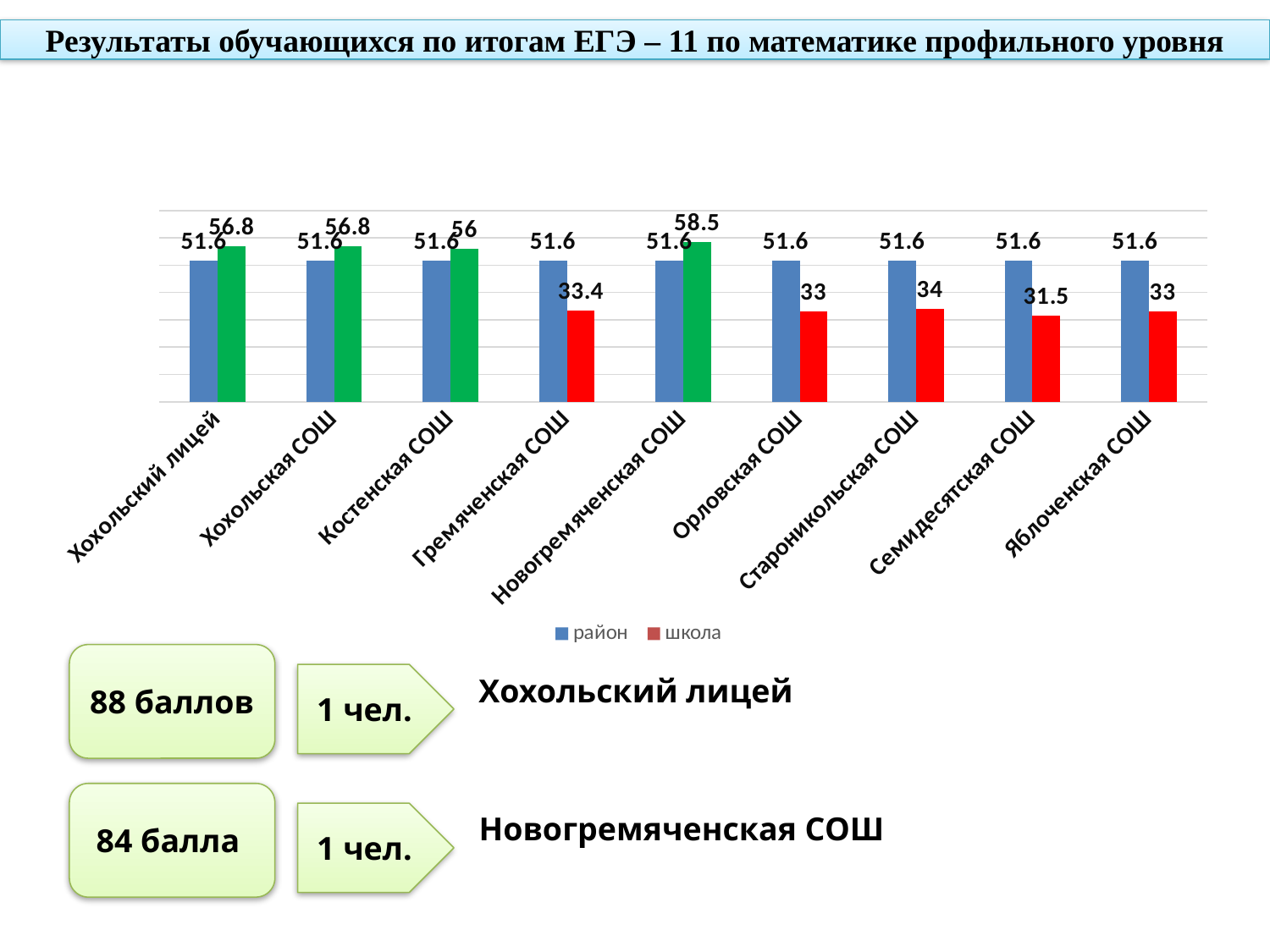
Which school has the lowest школа value? Семидесятская СОШ What is the школа value for Гремяченская СОШ? 33.4 What is the difference between the школа value and the район value for Новогремяченская СОШ? 6.9 How many series does the chart legend list? 2 What is the район value for Орловская СОШ? 51.6 What is the школа value for Новогремяченская СОШ? 58.5 What is the школа value for Семидесятская СОШ? 31.5 Which is larger for Старониколькая СОШ: the район value or the школа value? район What is the difference between the школа values of Костенская СОШ and Орловская СОШ? 23 What kind of chart is shown on the slide? bar chart How many schools are shown on the x axis of the chart? 9 Which school has the highest школа value? Новогремяченская СОШ